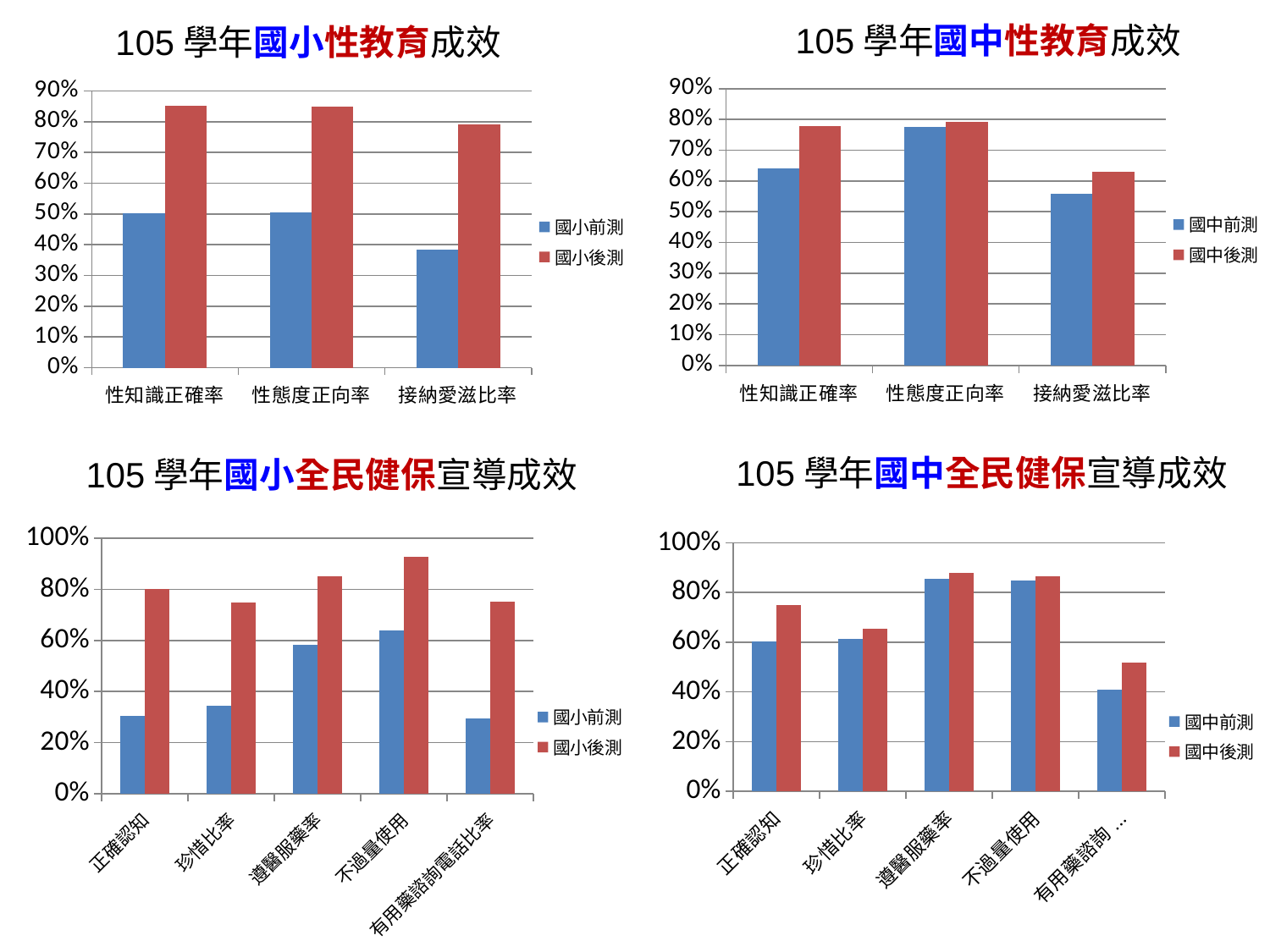
In the top-left chart (105 學年國小性教育成效), is the 國小前測 value for 接納愛滋比率 greater or less than 40%? less In the top-right chart (105 學年國中性教育成效), is the 國中後測 value for 性態度正向率 greater or less than 70%? greater In the bottom-left chart (105 學年國小全民健保宣導成效), which category has the highest 國小後測 value? 不過量使用 In the top-right chart (105 學年國中性教育成效), how many series does the legend list? 2 In the top-right chart (105 學年國中性教育成效), which category has the lowest 國中前測 value? 接納愛滋比率 In the top-right chart (105 學年國中性教育成效), which category has the highest 國中前測 value? 性態度正向率 What are the two legend entries in the bottom-left chart (105 學年國小全民健保宣導成效)? 國小前測, 國小後測 In the bottom-left chart (105 學年國小全民健保宣導成效), which category has the highest 國小前測 value? 不過量使用 In the top-left chart (105 學年國小性教育成效), is the 國小後測 value for 性知識正確率 greater or less than 80%? greater What kind of chart is the top-left chart titled 105 學年國小性教育成效? bar chart In the bottom-right chart (105 學年國中全民健保宣導成效), which is larger for 國中前測: 正確認知 or 遵醫服藥率? 遵醫服藥率 In the bottom-left chart (105 學年國小全民健保宣導成效), how many categories are shown on the x axis? 5